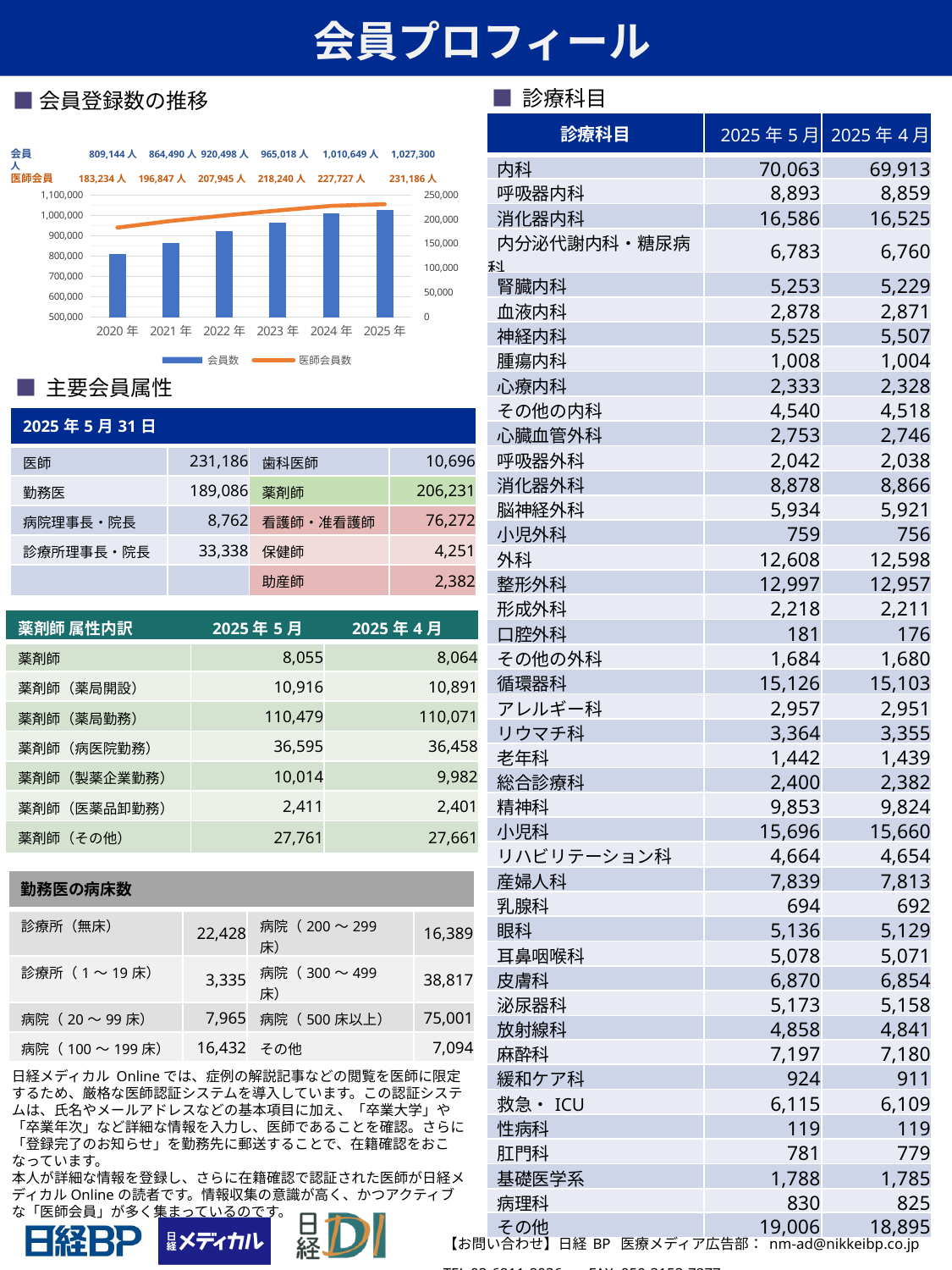
In the 会員登録数の推移 chart, is the 会員 value for 2021年 larger or smaller than the 会員 value for 2022年? smaller How many years are shown on the x axis of the 会員登録数の推移 chart? 6 How many series does the legend of the 会員登録数の推移 chart list? 2 In the 会員登録数の推移 chart, by how much did the 医師会員 value increase from 2020年 to 2025年? 47,952 In the 会員登録数の推移 chart, what is the 会員 value for 2023年? 965,018人 In the 会員登録数の推移 chart, do the 会員 values rise or fall from 2020年 to 2025年? rise In the 会員登録数の推移 chart, which year has the highest 会員 value? 2025年 In the 会員登録数の推移 chart, what is the difference between the 会員 values for 2025年 and 2024年? 16,651 In the 会員登録数の推移 chart, what is the 会員 value for 2020年? 809,144人 In the 会員登録数の推移 chart, what is the 医師会員 value for 2025年? 231,186人 In the 会員登録数の推移 chart, what is the 医師会員 value for 2022年? 207,945人 In the 会員登録数の推移 chart, which year has the lowest 医師会員 value? 2020年